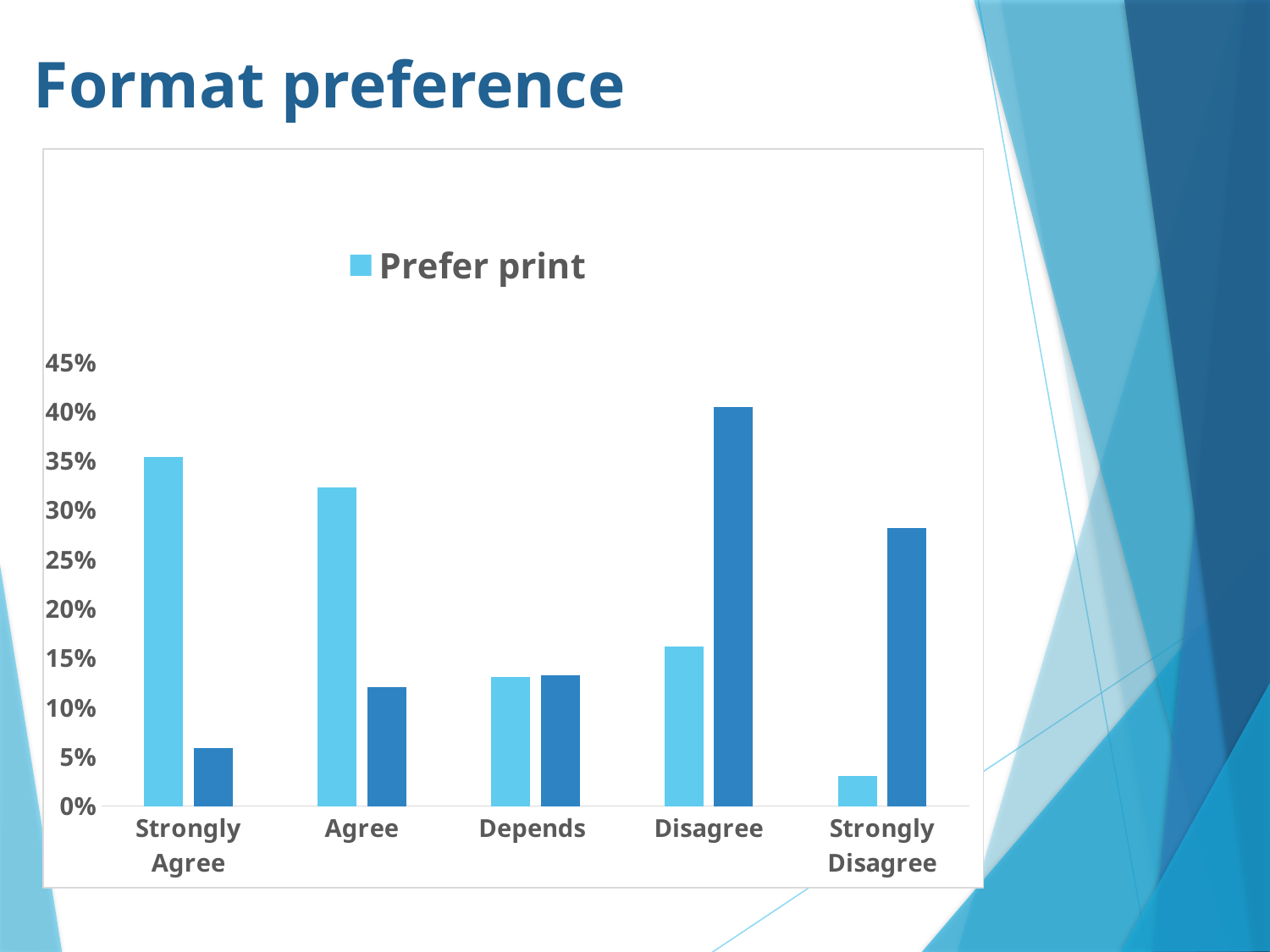
What kind of chart is shown on the slide? bar chart Is the Prefer print value for Strongly Disagree greater or less than 5%? less What is the title of the slide containing the chart? Format preference What series name is shown in the chart's legend? Prefer print Which category has the lowest value for the Prefer print series? Strongly Disagree Is the Prefer print value for Disagree greater or less than 20%? less How many series does the chart's legend list? 1 Is the Prefer print value for Strongly Agree greater or less than 30%? greater For the Prefer print series, which is larger: the value for Agree or the value for Disagree? Agree Which category has the highest value for the Prefer print series? Strongly Agree How many categories are shown on the x axis of the chart? 5